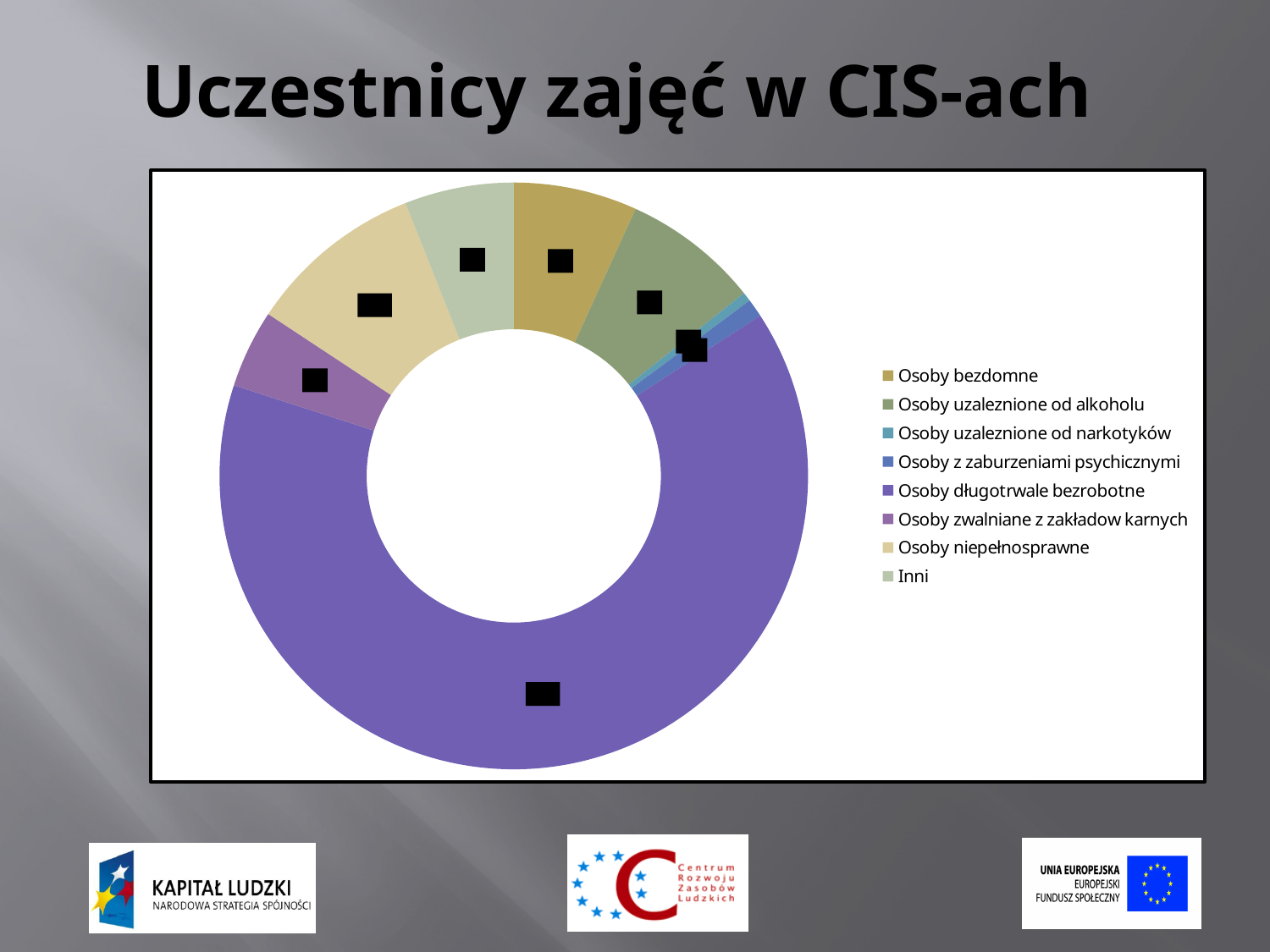
Does the slice for Osoby długotrwale bezrobotne take up more or less than half of the doughnut? more Which slice is larger: Osoby długotrwale bezrobotne or Osoby bezdomne? Osoby długotrwale bezrobotne Which legend entry is listed last in the chart's legend? Inni What kind of chart is shown on the slide? Doughnut chart How many categories does the chart's legend list? 8 Which slice is larger: Osoby uzaleznione od alkoholu or Osoby uzaleznione od narkotyków? Osoby uzaleznione od alkoholu Which category has the largest slice of the doughnut? Osoby długotrwale bezrobotne Which slice is larger: Osoby bezdomne or Osoby z zaburzeniami psychicznymi? Osoby bezdomne What is the title of the slide containing the chart? Uczestnicy zajęć w CIS-ach